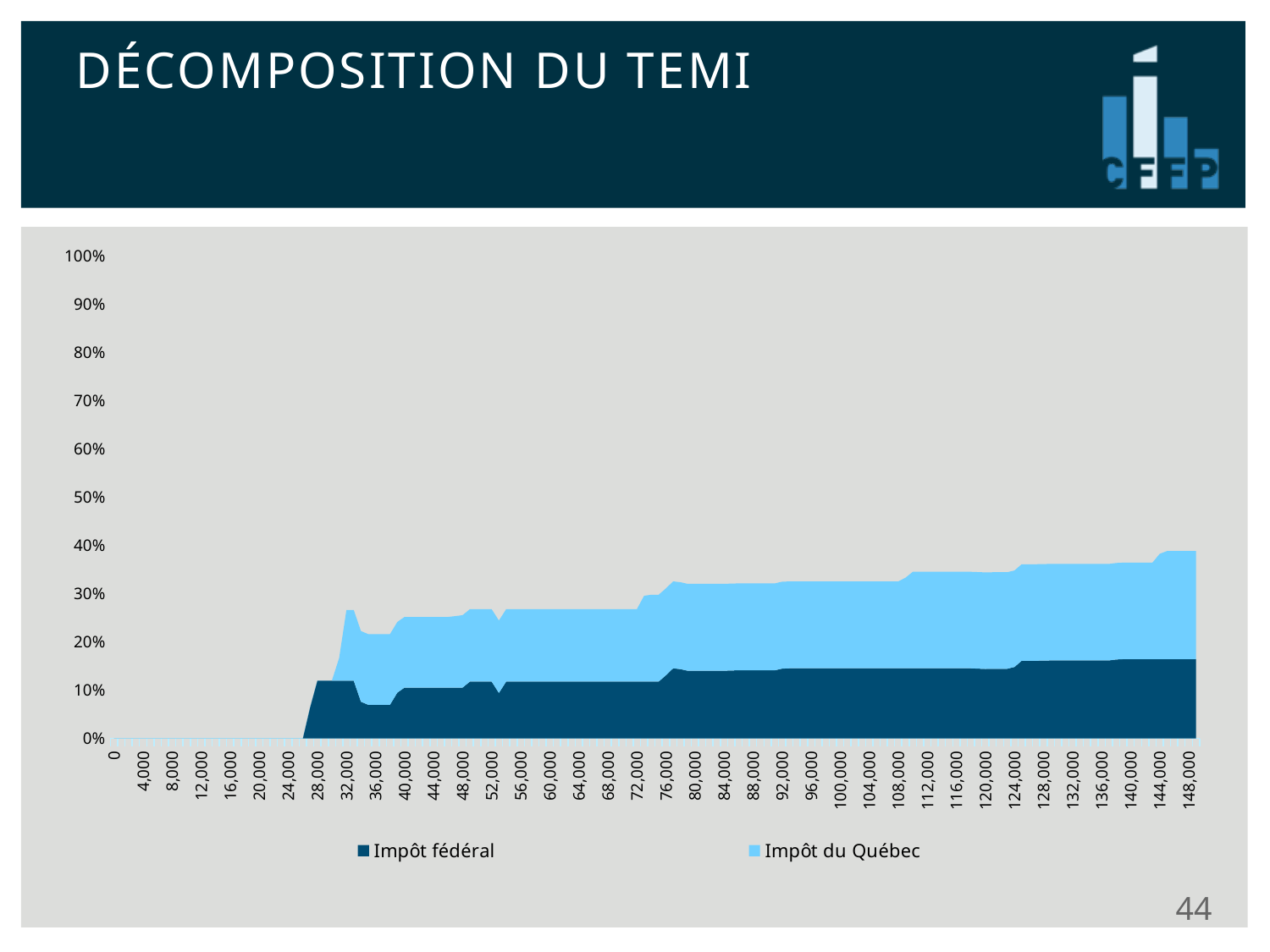
Is the value for Impôt fédéral at 36,000 greater or less than 10%? less Is the combined value of both series at 20,000 greater or less than 10%? less What are the two series named in the legend? Impôt fédéral and Impôt du Québec What is the highest value shown on the vertical axis? 100% Is the combined value of both series at 100,000 greater or less than 20%? greater At 148,000, which series contributes more: Impôt fédéral or Impôt du Québec? Impôt du Québec What is the title of the slide containing the chart? DÉCOMPOSITION DU TEMI What kind of chart is shown on the slide? Stacked area chart How many series does the legend list? 2 Do the combined values generally rise or fall as income increases from 28,000 to 148,000? rise